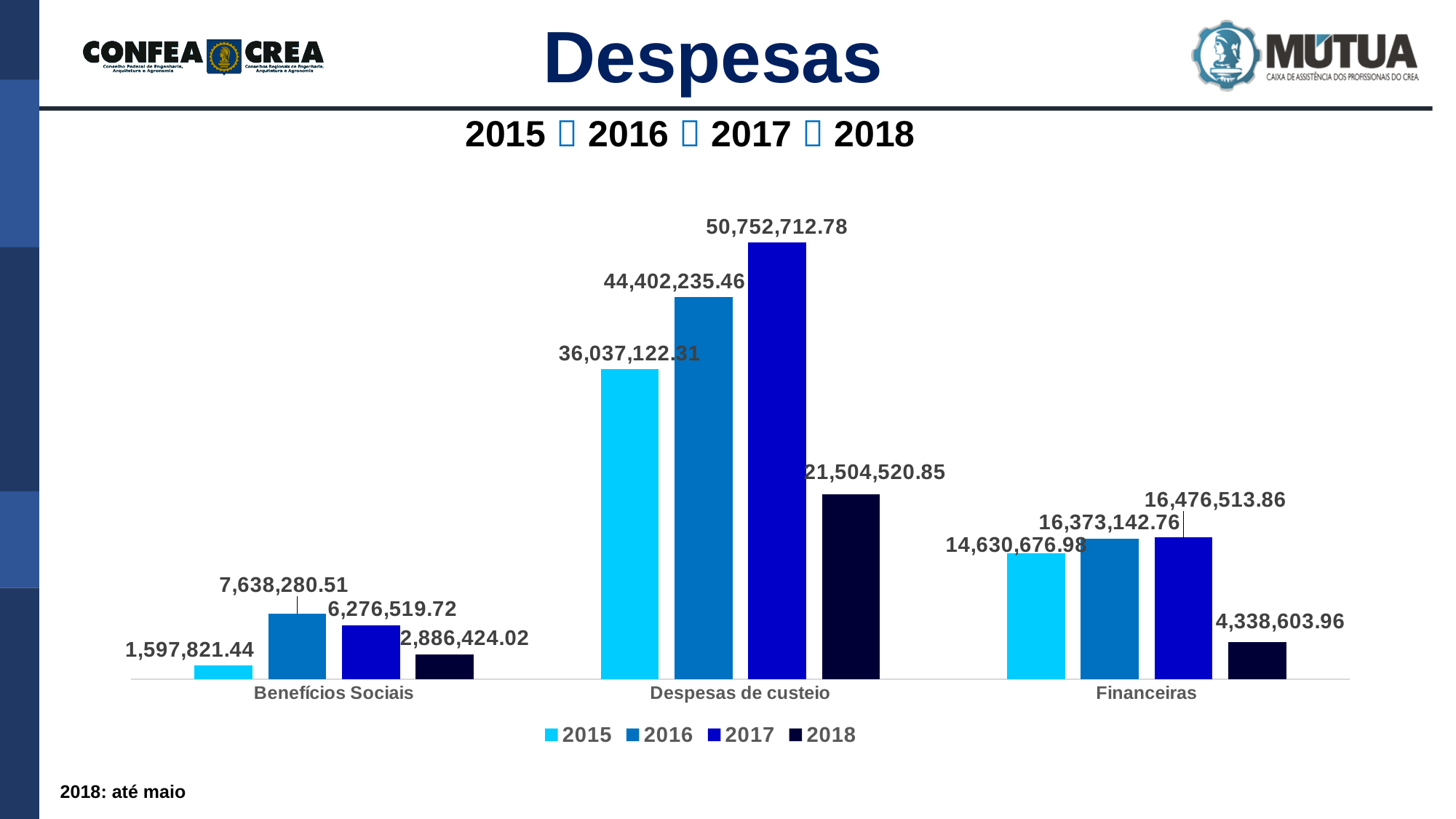
What is the value for 2017 in the Despesas de custeio category? 50,752,712.78 What type of chart is shown on the slide? bar chart How many series does the legend list? 4 Which year has the lowest value in the Benefícios Sociais category? 2015 Which is larger in the Benefícios Sociais category: the 2016 value or the 2018 value? 2016 What is the difference between the 2015 and 2018 values in the Financeiras category? 10,292,073.02 What is the title of the chart on the slide? Despesas What is the difference between the 2017 and 2016 values in the Despesas de custeio category? 6,350,477.32 How many categories are shown on the x axis? 3 Which year has the highest value in the Despesas de custeio category? 2017 What is the value for 2018 in the Financeiras category? 4,338,603.96 What is the value for 2015 in the Benefícios Sociais category? 1,597,821.44